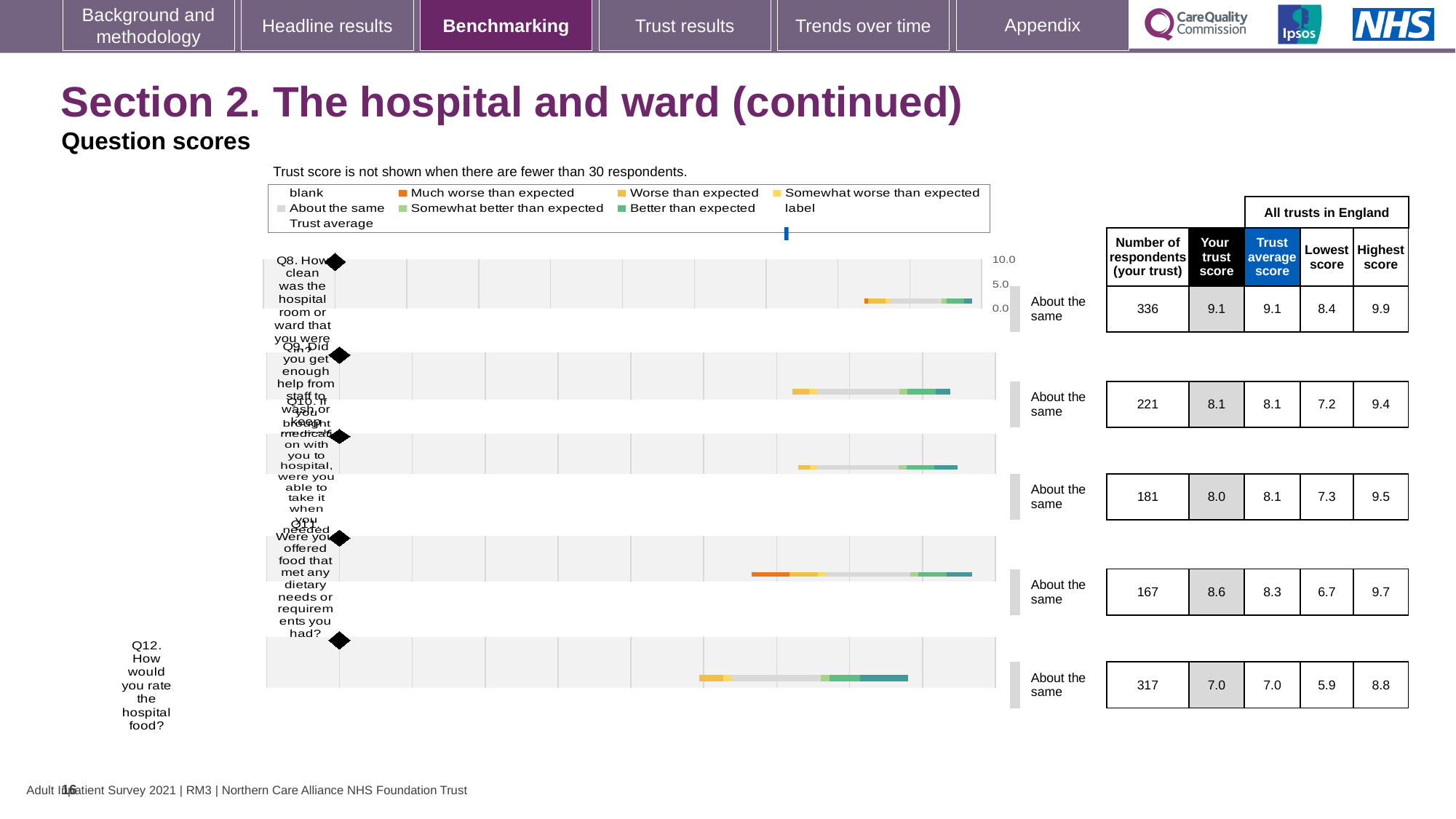
Which question has the highest trust score on this slide? Q8 How many respondents from the trust answered Q8 (How clean was the hospital room or ward)? 336 What is the lowest score across all trusts in England for Q12? 5.9 What is the trust score shown for Q12 (How would you rate the hospital food?)? 7.0 Which is larger for Q10: the trust score or the trust average score? Trust average score What is the difference between the trust score and the trust average score for Q11? 0.3 What benchmark category is shown for every question on this slide? About the same Which question has the lowest trust score on this slide? Q12 How many questions are plotted in the chart? 5 What is the highest score across all trusts in England for Q9 (Did you get enough help from staff to wash or keep yourself clean)? 9.4 What is the trust average score for Q11 (Were you offered food that met any dietary needs or requirements you had?)? 8.3 What kind of chart is used to show the question scores? Bar chart